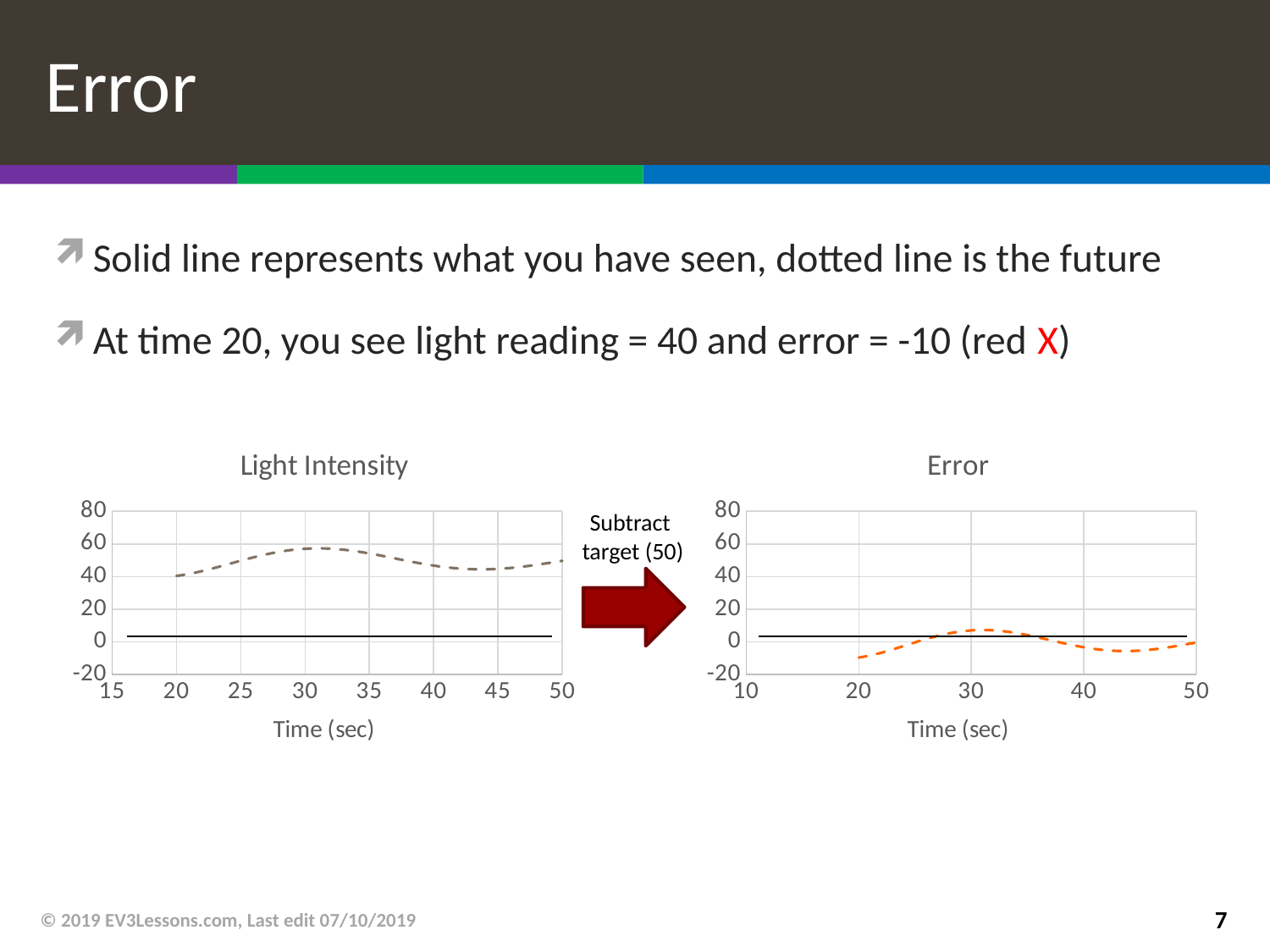
In the Light Intensity chart, does the dotted line rise or fall between time 20 and time 30? rise What kind of chart is the Error chart? line chart In the Error chart, what is the error value at time 20? -10 In the Error chart, is the value at time 45 greater or less than 0? less In the Light Intensity chart, which is larger: the value at time 30 or the value at time 20? time 30 In the Error chart, is the value at time 30 greater or less than 0? greater What is the title of the chart on the left of the slide? Light Intensity What is the x-axis title of the Error chart? Time (sec) In the Light Intensity chart, is the value at time 30 greater or less than 40? greater In the Light Intensity chart, what is the light reading at time 20? 40 In the Error chart, does the dotted line rise or fall between time 30 and time 45? fall What kind of chart is the Light Intensity chart? line chart